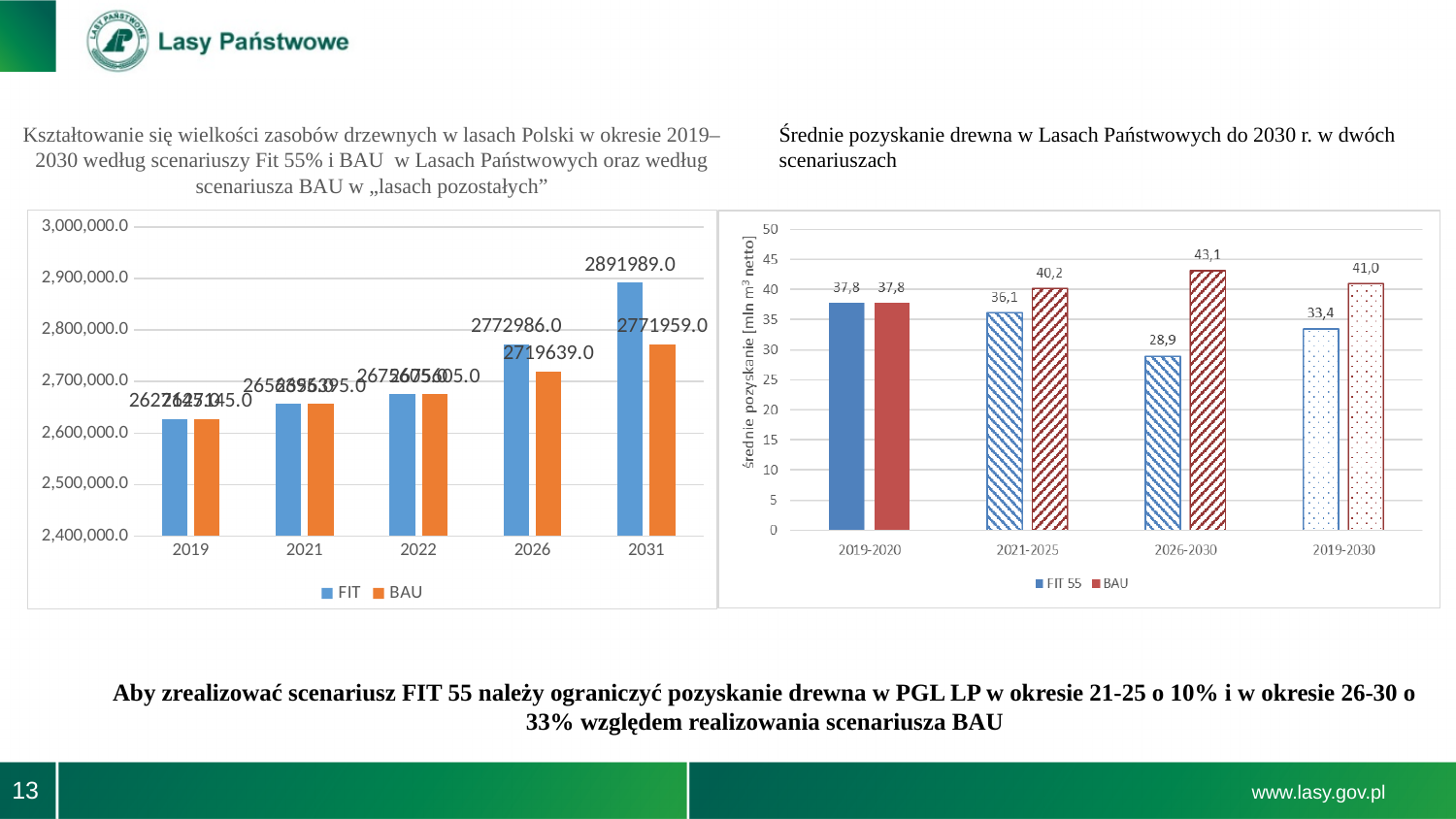
In the right chart (Średnie pozyskanie drewna), what is the value for FIT 55 in 2021-2025? 36,1 In the right chart (Średnie pozyskanie drewna), what is the value for BAU in 2026-2030? 43,1 In the right chart (Średnie pozyskanie drewna), how many series does the legend list? 2 In the right chart (Średnie pozyskanie drewna), do the FIT 55 values rise or fall from 2019-2020 to 2026-2030? fall What kind of chart is the left chart (Kształtowanie się wielkości zasobów drzewnych)? bar chart In the left chart (Kształtowanie się wielkości zasobów drzewnych), what is the FIT value for 2031? 2891989.0 In the left chart (Kształtowanie się wielkości zasobów drzewnych), how many year categories are shown on the x axis? 5 In the right chart (Średnie pozyskanie drewna), which period has the lowest FIT 55 value? 2026-2030 In the right chart (Średnie pozyskanie drewna), what is the value for FIT 55 in 2019-2030? 33,4 In the right chart (Średnie pozyskanie drewna), which is larger in 2021-2025, FIT 55 or BAU? BAU In the right chart (Średnie pozyskanie drewna), what is the difference between BAU and FIT 55 in 2026-2030? 14,2 In the left chart (Kształtowanie się wielkości zasobów drzewnych), what is the BAU value for 2026? 2719639.0